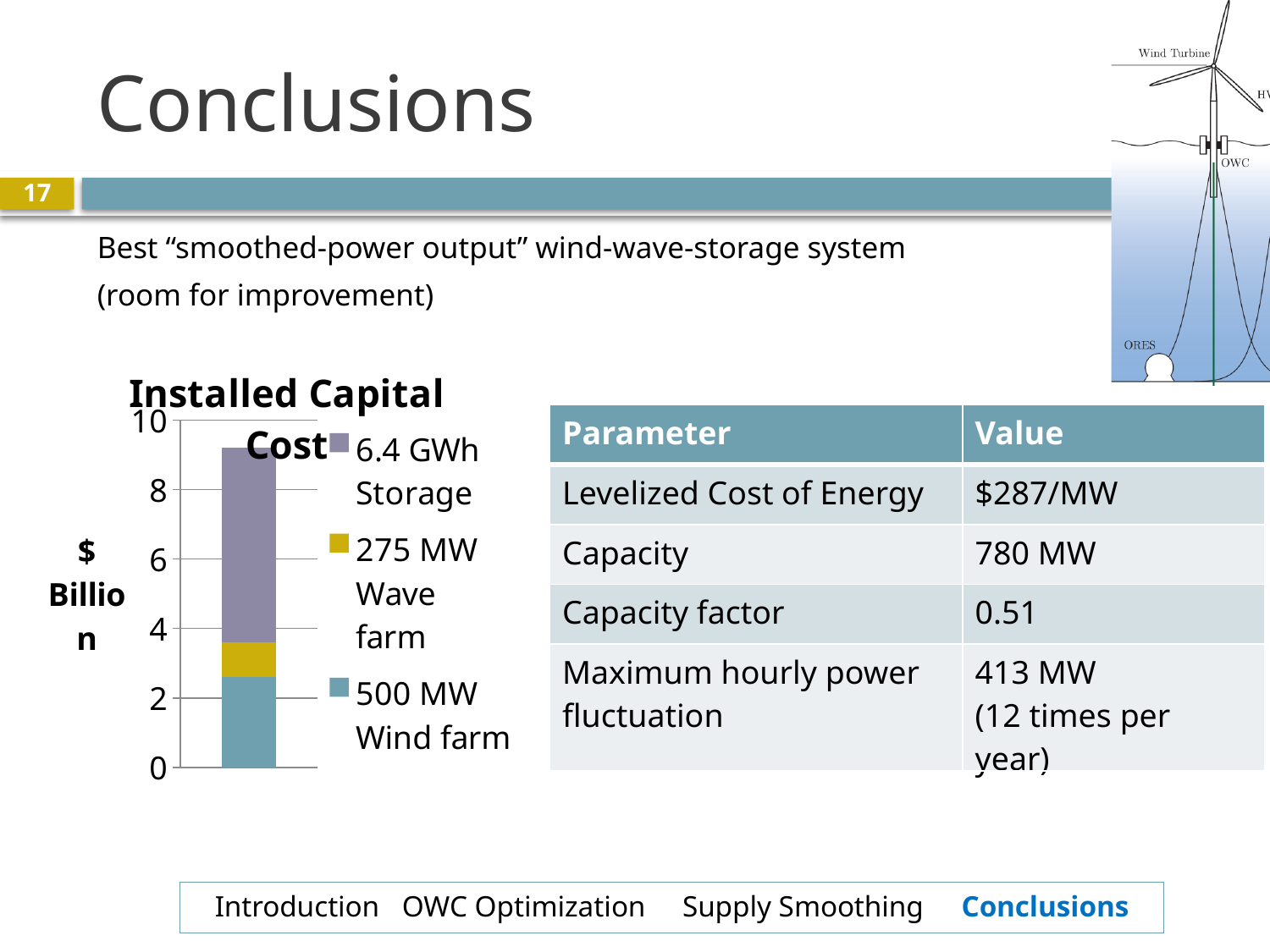
In the Installed Capital Cost chart, which segment is larger: 500 MW Wind farm or 275 MW Wave farm? 500 MW Wind farm How many series does the legend of the Installed Capital Cost chart list? 3 How many stacked bars are plotted in the Installed Capital Cost chart? 1 What is the title of the chart on the slide? Installed Capital Cost In the Installed Capital Cost chart, is the value for 6.4 GWh Storage greater or less than 4? greater In the Installed Capital Cost chart, which series makes up the largest segment of the bar? 6.4 GWh Storage In the Installed Capital Cost chart, is the value for 500 MW Wind farm greater or less than 4? less In the Installed Capital Cost chart, is the total height of the stacked bar greater or less than 8? greater In the Installed Capital Cost chart, which series makes up the smallest segment of the bar? 275 MW Wave farm What kind of chart is the Installed Capital Cost chart? Stacked bar chart What is the label on the vertical axis of the Installed Capital Cost chart? $ Billion